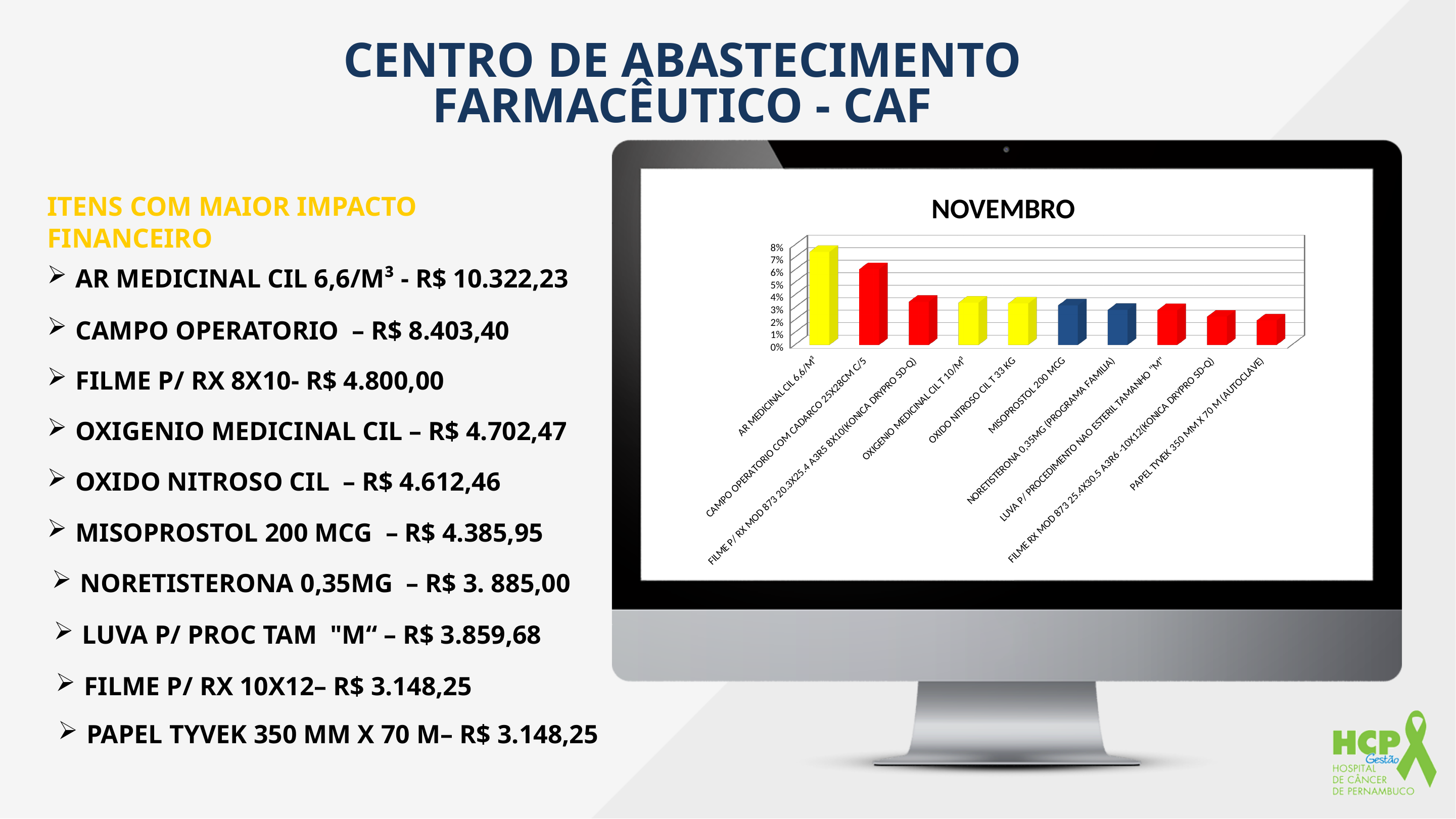
What kind of chart is shown on the slide? Bar chart How many categories (bars) are plotted in the NOVEMBRO chart? 10 In the NOVEMBRO chart, which is larger: CAMPO OPERATORIO COM CADARCO 25X28CM C/5 or FILME P/ RX MOD 873 20.3X25.4 A3R5 8X10(KONICA DRYPRO SD-Q)? CAMPO OPERATORIO COM CADARCO 25X28CM C/5 In the NOVEMBRO chart, is the value for MISOPROSTOL 200 MCG greater or less than 5%? less Which category has the highest value in the NOVEMBRO chart? AR MEDICINAL CIL 6,6/M³ In the NOVEMBRO chart, which is larger: AR MEDICINAL CIL 6,6/M³ or CAMPO OPERATORIO COM CADARCO 25X28CM C/5? AR MEDICINAL CIL 6,6/M³ What is the highest value shown on the vertical axis of the NOVEMBRO chart? 8% In the NOVEMBRO chart, is the value for PAPEL TYVEK 350 MM X 70 M (AUTOCLAVE) greater or less than 4%? less What is the title of the chart on the slide? NOVEMBRO In the NOVEMBRO chart, is the value for CAMPO OPERATORIO COM CADARCO 25X28CM C/5 greater or less than 5%? greater Do the bar values in the NOVEMBRO chart generally rise or fall from left to right? Fall